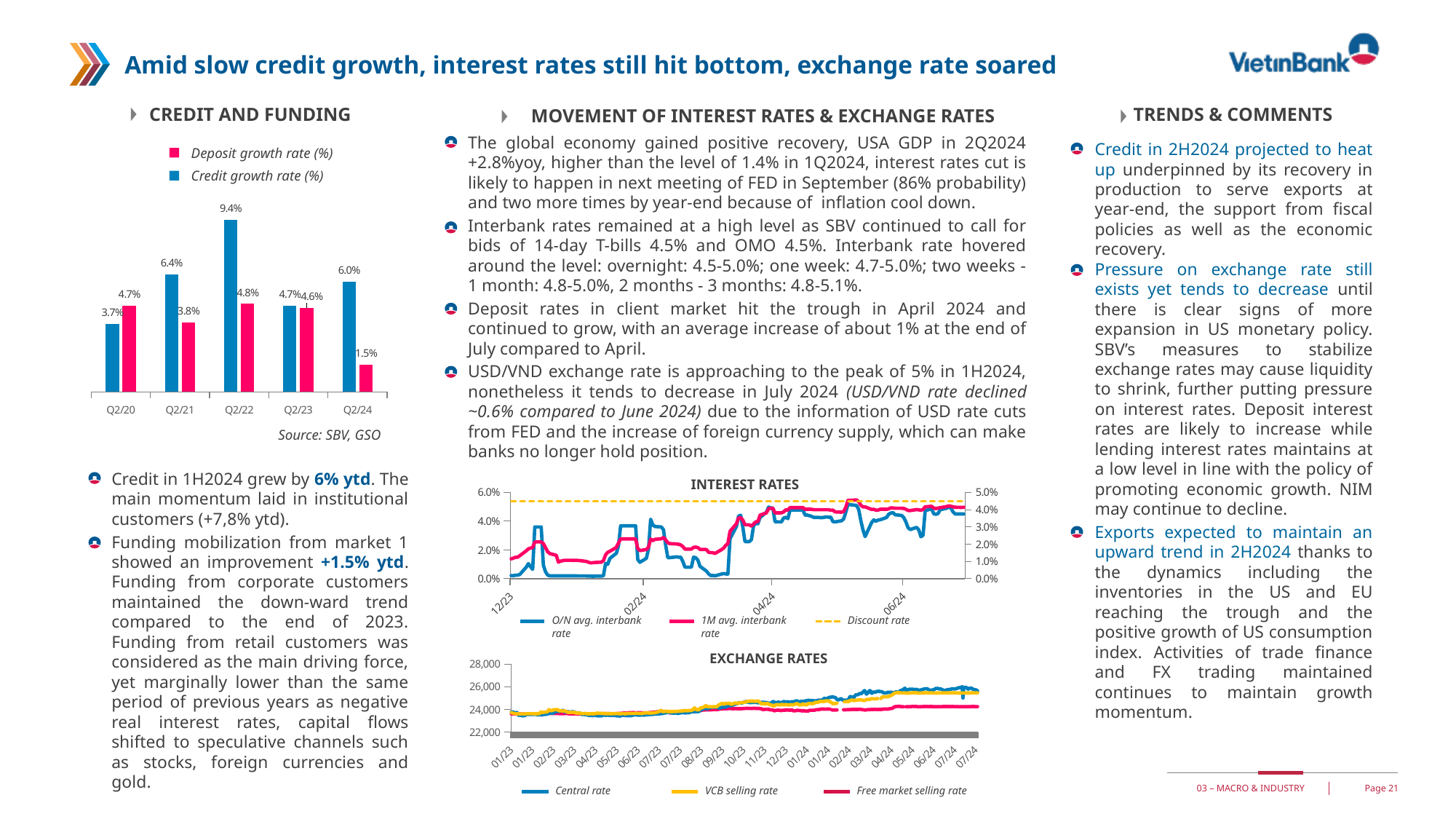
How many series does the legend of the INTEREST RATES chart list? 3 In the bar chart under CREDIT AND FUNDING, what is the difference between the credit growth rate and the deposit growth rate in Q2/24? 4.5% In the bar chart under CREDIT AND FUNDING, what is the deposit growth rate for Q2/24? 1.5% In the bar chart under CREDIT AND FUNDING, which quarter has the lowest deposit growth rate? Q2/24 In the bar chart under CREDIT AND FUNDING, which quarter has the highest credit growth rate? Q2/22 In the EXCHANGE RATES chart, which series is shown in yellow? VCB selling rate What kind of chart is used under CREDIT AND FUNDING? Bar chart In the bar chart under CREDIT AND FUNDING, which is larger in Q2/20: the credit growth rate or the deposit growth rate? Deposit growth rate In the bar chart under CREDIT AND FUNDING, what is the credit growth rate for Q2/22? 9.4% How many quarters are shown on the x axis of the bar chart under CREDIT AND FUNDING? 5 How many series does the legend of the bar chart under CREDIT AND FUNDING list? 2 What kind of chart is the EXCHANGE RATES chart? Line chart